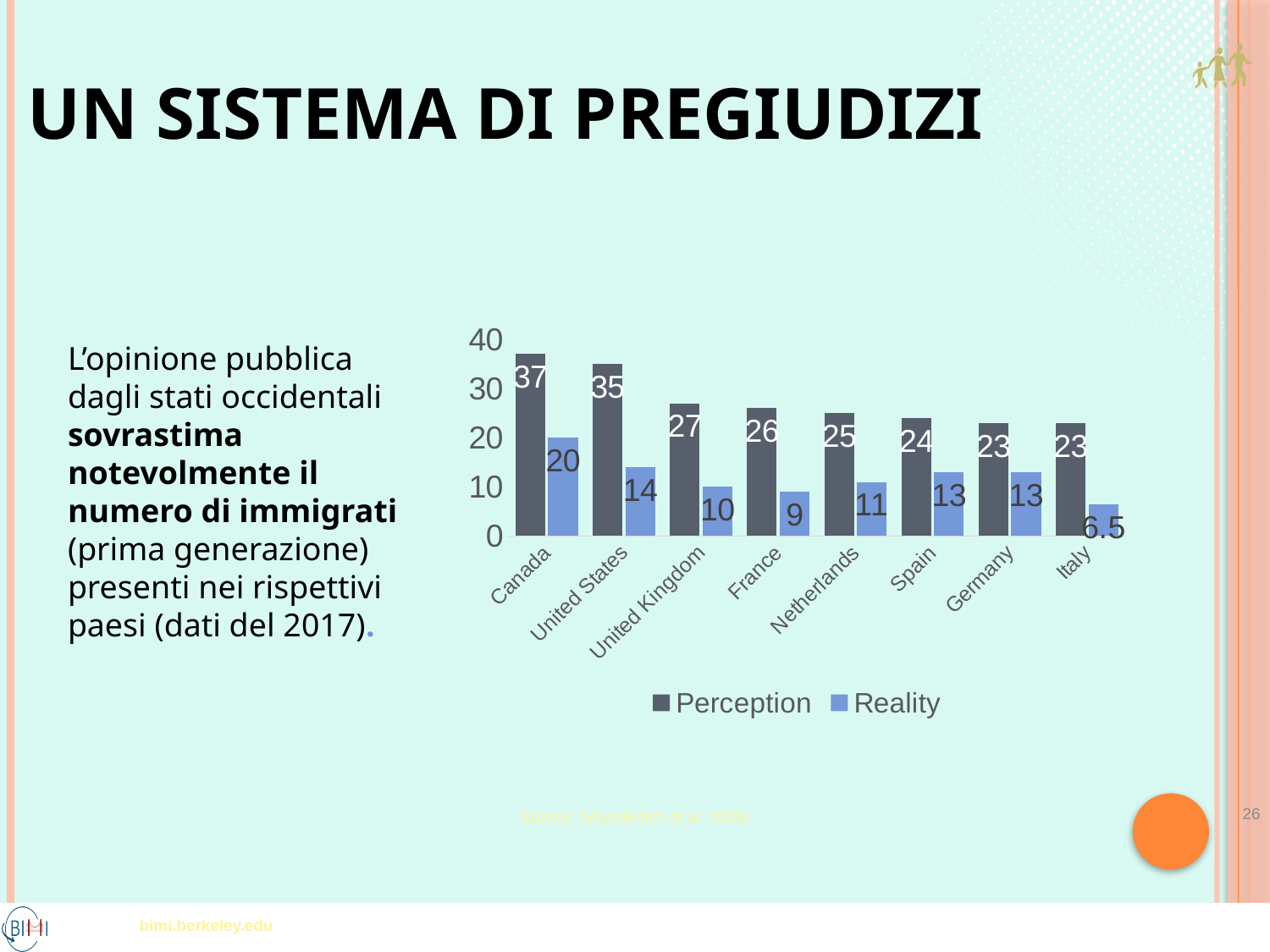
Which series is shown in dark grey in the legend? Perception How many series does the legend list? 2 What is the Perception value for Canada? 37 How many countries are shown on the x axis? 8 What kind of chart is shown on the slide? Bar chart What is the Reality value for Italy? 6.5 What is the difference between the Perception and Reality values for the United States? 21 Which country has the highest Perception value? Canada Is the Perception value for France greater or less than 20? greater Which country has the lowest Reality value? Italy What is the Reality value for the United Kingdom? 10 Which is larger, the Reality value for Canada or the Reality value for Spain? Canada